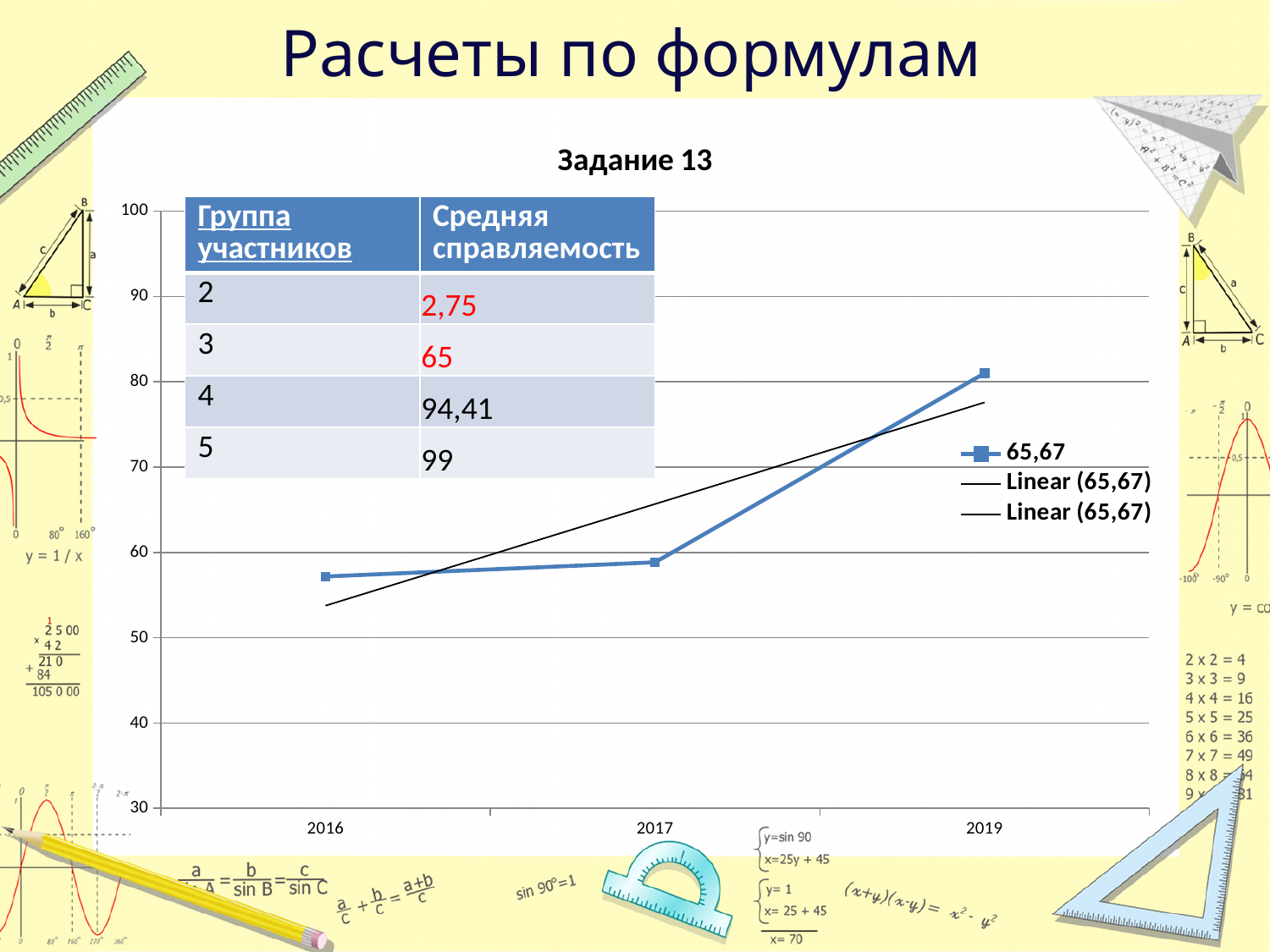
Which year has the highest value on the blue line? 2019 How many data points are plotted on the blue line? 3 Is the value for 2017 greater or less than 70? less What is the title of the chart? Задание 13 Is the value for 2019 greater or less than 70? greater Do the values on the blue line rise or fall from 2016 to 2019? rise How many entries does the chart legend list? 3 What is the highest tick value shown on the vertical axis? 100 What kind of chart is shown on the slide? line chart What is the name of the blue series with square markers in the legend? 65,67 Is the value for 2016 greater or less than 60? less Which is larger, the value for 2016 or the value for 2019? 2019